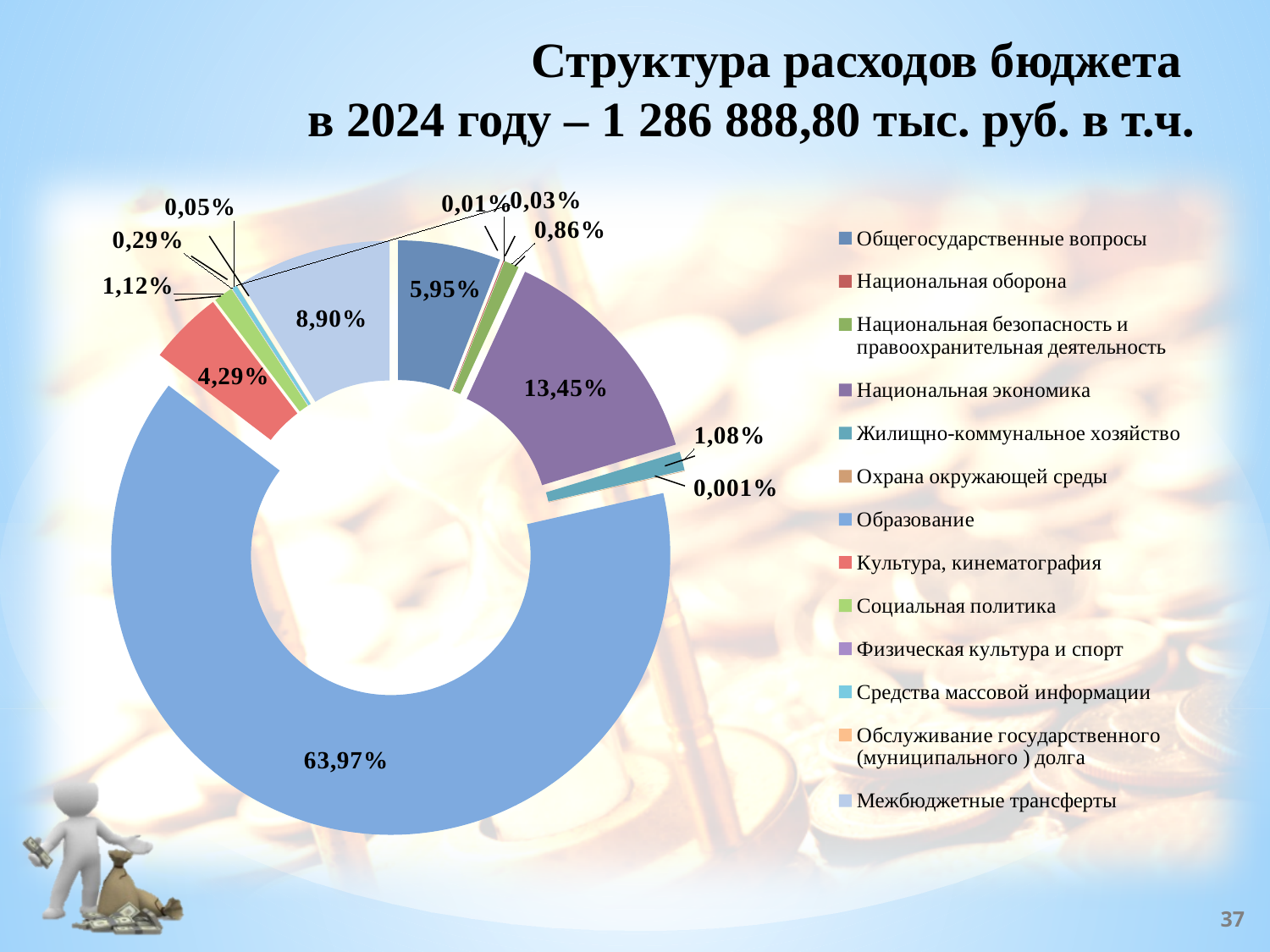
What is the share for Культура, кинематография? 4,29% What is the value for Жилищно-коммунальное хозяйство? 1,08% What percentage is shown for Межбюджетные трансферты? 8,90% What is the value shown for Национальная экономика? 13,45% What kind of chart is shown on the slide? Pie (doughnut) chart What percentage is shown for Общегосударственные вопросы? 5,95% How many categories does the legend list? 13 Which is larger: the share for Национальная экономика or for Межбюджетные трансферты? Национальная экономика What share of budget expenditure does Образование account for? 63,97% Which category has the smallest share shown on the chart? Обслуживание государственного (муниципального) долга Which category has the largest share of the budget expenditure? Образование What is the difference between the shares for Общегосударственные вопросы and Культура, кинематография? 1,66%